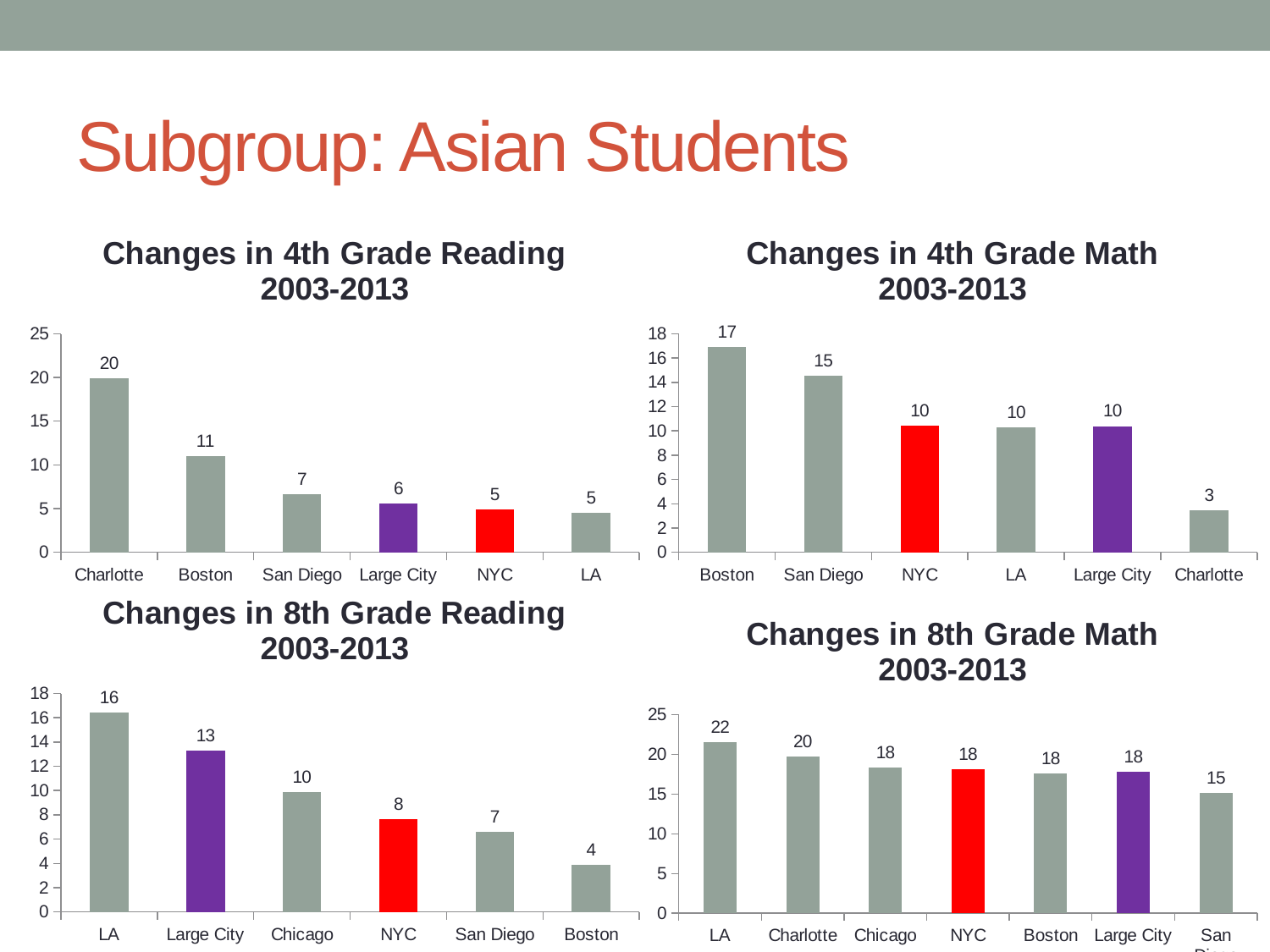
In the 'Changes in 8th Grade Math 2003-2013' chart, what is the value for San Diego? 15 What type of chart is the 'Changes in 8th Grade Math 2003-2013' chart? bar chart In the 'Changes in 8th Grade Reading 2003-2013' chart, what is the value for Large City? 13 In the 'Changes in 8th Grade Reading 2003-2013' chart, do the values rise or fall from left to right along the x axis? fall In the 'Changes in 4th Grade Math 2003-2013' chart, how many categories are shown? 6 In the 'Changes in 4th Grade Reading 2003-2013' chart, what is the difference between Boston and San Diego? 4 In the 'Changes in 4th Grade Reading 2003-2013' chart, which city has the highest value? Charlotte In the 'Changes in 8th Grade Math 2003-2013' chart, how many categories are shown? 7 In the 'Changes in 4th Grade Math 2003-2013' chart, which category has the lowest value? Charlotte In the 'Changes in 4th Grade Reading 2003-2013' chart, what is the value for Charlotte? 20 In the 'Changes in 4th Grade Math 2003-2013' chart, what is the value for Boston? 17 In the 'Changes in 8th Grade Reading 2003-2013' chart, which is larger, the value for Chicago or the value for NYC? Chicago